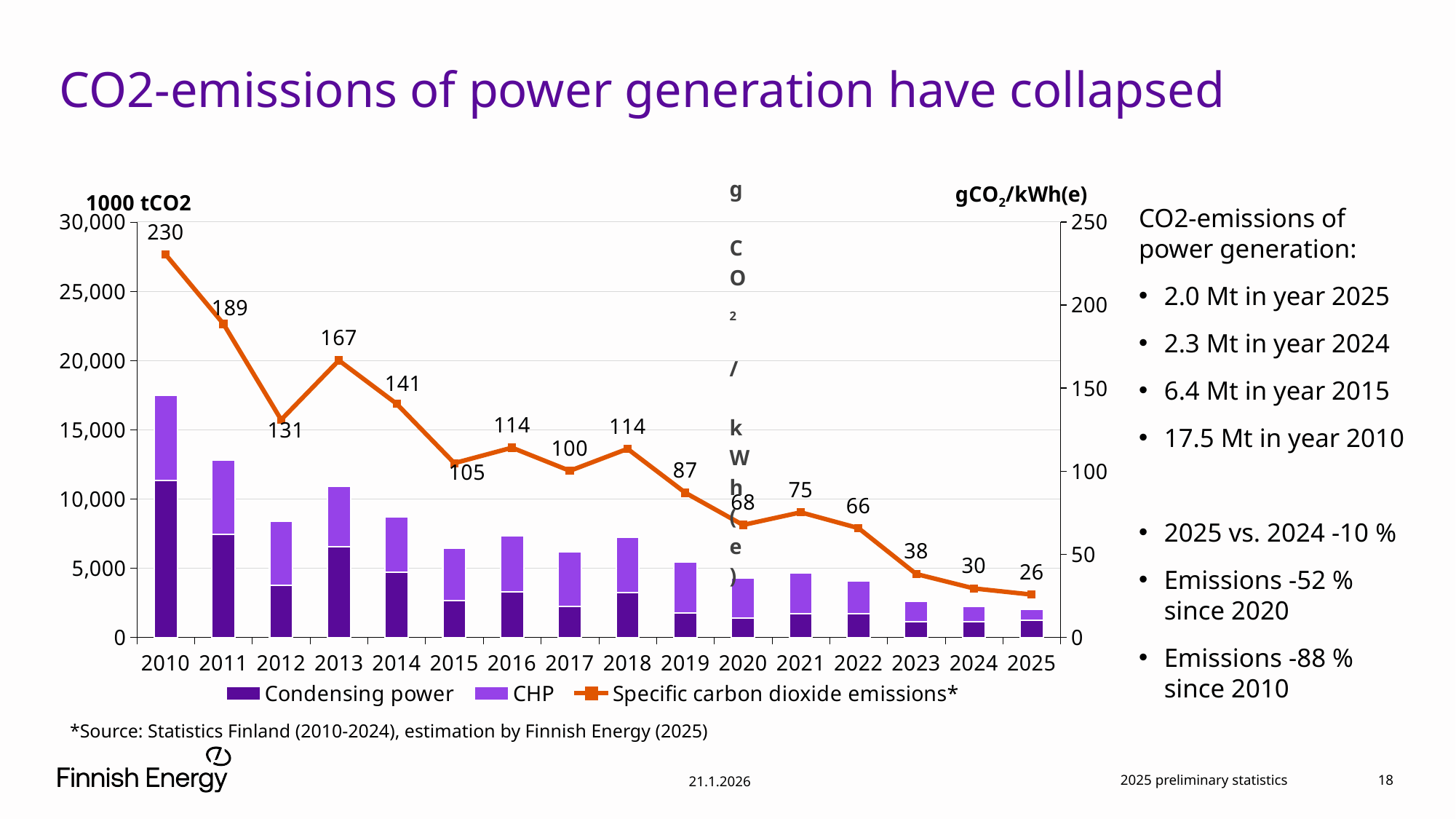
In which year is the Specific carbon dioxide emissions line at its lowest? 2025 What is the value of the Specific carbon dioxide emissions line for 2013? 167 How many series does the legend list? 3 What is the value of the Specific carbon dioxide emissions line for 2010? 230 What is the value of the Specific carbon dioxide emissions line for 2025? 26 Which year has a higher Specific carbon dioxide emissions value, 2012 or 2013? 2013 Is the total stacked bar for 2025 greater or less than 5,000? less Is the total stacked bar for 2010 greater or less than 15,000? greater In which year is the Specific carbon dioxide emissions line at its highest? 2010 What is the difference between the Specific carbon dioxide emissions values for 2010 and 2011? 41 What is the overall trend of the Specific carbon dioxide emissions line from 2010 to 2025? falling How many years are shown on the x axis? 16